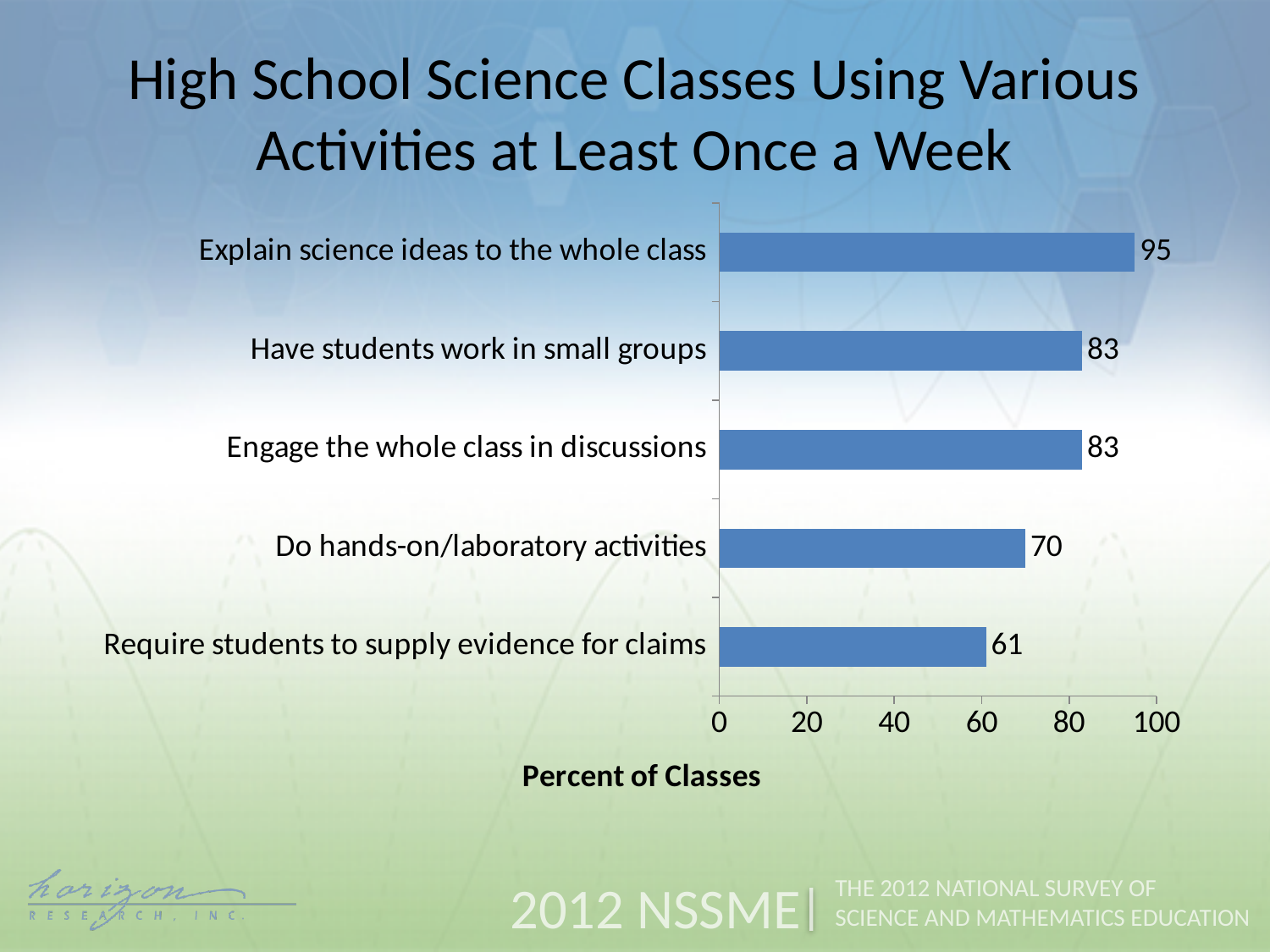
What is the difference between the values for "Explain science ideas to the whole class" and "Require students to supply evidence for claims"? 34 What is the label of the horizontal axis? Percent of Classes Which activity has the lowest value? Require students to supply evidence for claims What is the value for "Do hands-on/laboratory activities"? 70 Which is larger, the value for "Do hands-on/laboratory activities" or the value for "Engage the whole class in discussions"? Engage the whole class in discussions Which activity has the highest value? Explain science ideas to the whole class What is the value for "Require students to supply evidence for claims"? 61 What is the difference between the values for "Have students work in small groups" and "Do hands-on/laboratory activities"? 13 What kind of chart is shown on the slide? Bar chart What is the value for "Explain science ideas to the whole class"? 95 What is the value for "Have students work in small groups"? 83 How many activities are shown in the chart? 5